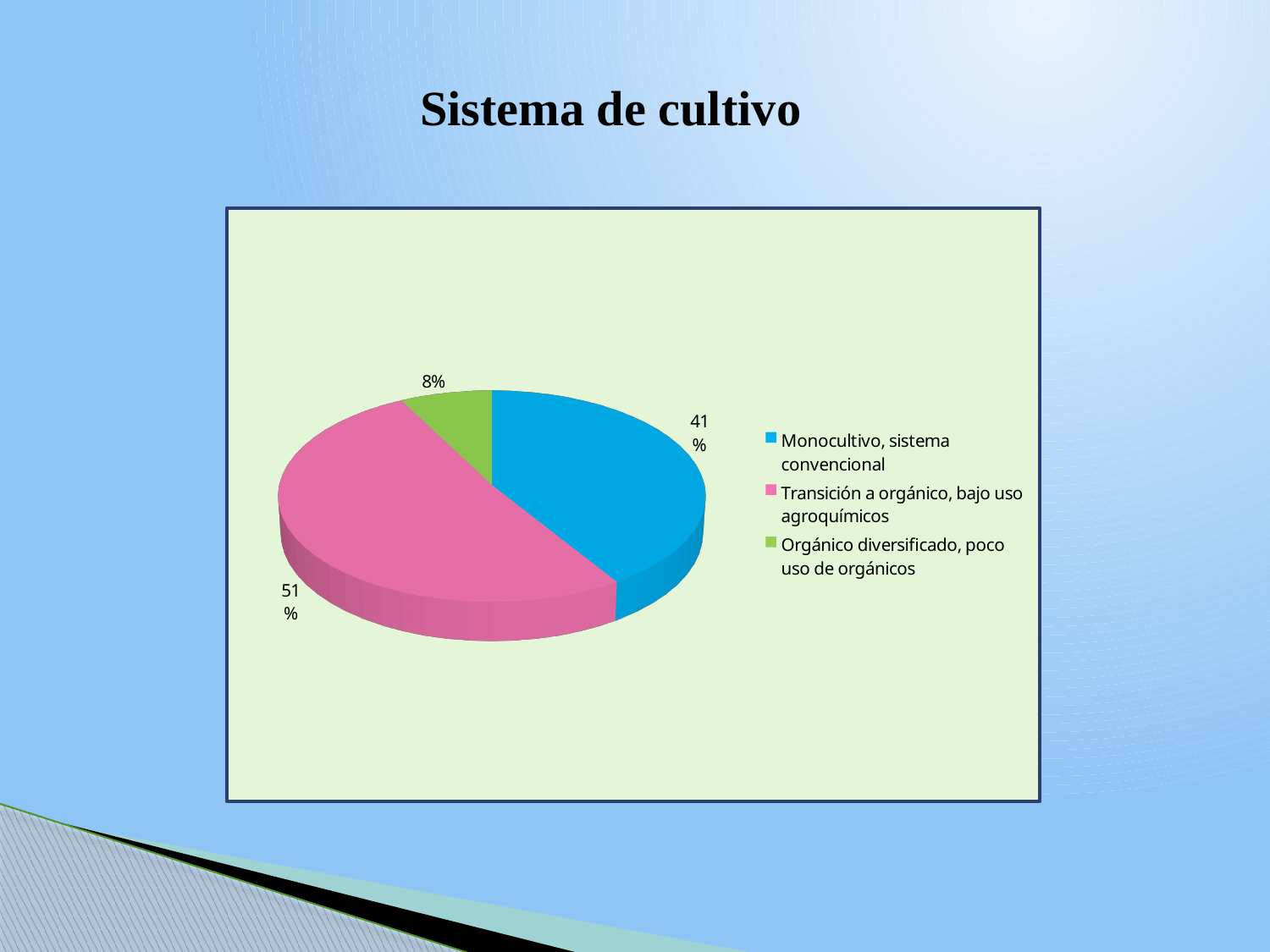
What is the difference in percentage points between 'Transición a orgánico, bajo uso agroquímicos' and 'Monocultivo, sistema convencional'? 10 Which category has the smallest slice of the pie? Orgánico diversificado, poco uso de orgánicos How many categories does the pie chart have? 3 What share of the pie is 'Monocultivo, sistema convencional'? 41% Which is larger: the slice for 'Monocultivo, sistema convencional' or the slice for 'Orgánico diversificado, poco uso de orgánicos'? Monocultivo, sistema convencional How many entries does the legend list? 3 What kind of chart is shown on the slide? pie chart What share of the pie is 'Orgánico diversificado, poco uso de orgánicos'? 8% What is the title of the slide above the chart? Sistema de cultivo Which category has the largest slice of the pie? Transición a orgánico, bajo uso agroquímicos What colour is the slice for 'Transición a orgánico, bajo uso agroquímicos'? pink What share of the pie is 'Transición a orgánico, bajo uso agroquímicos'? 51%